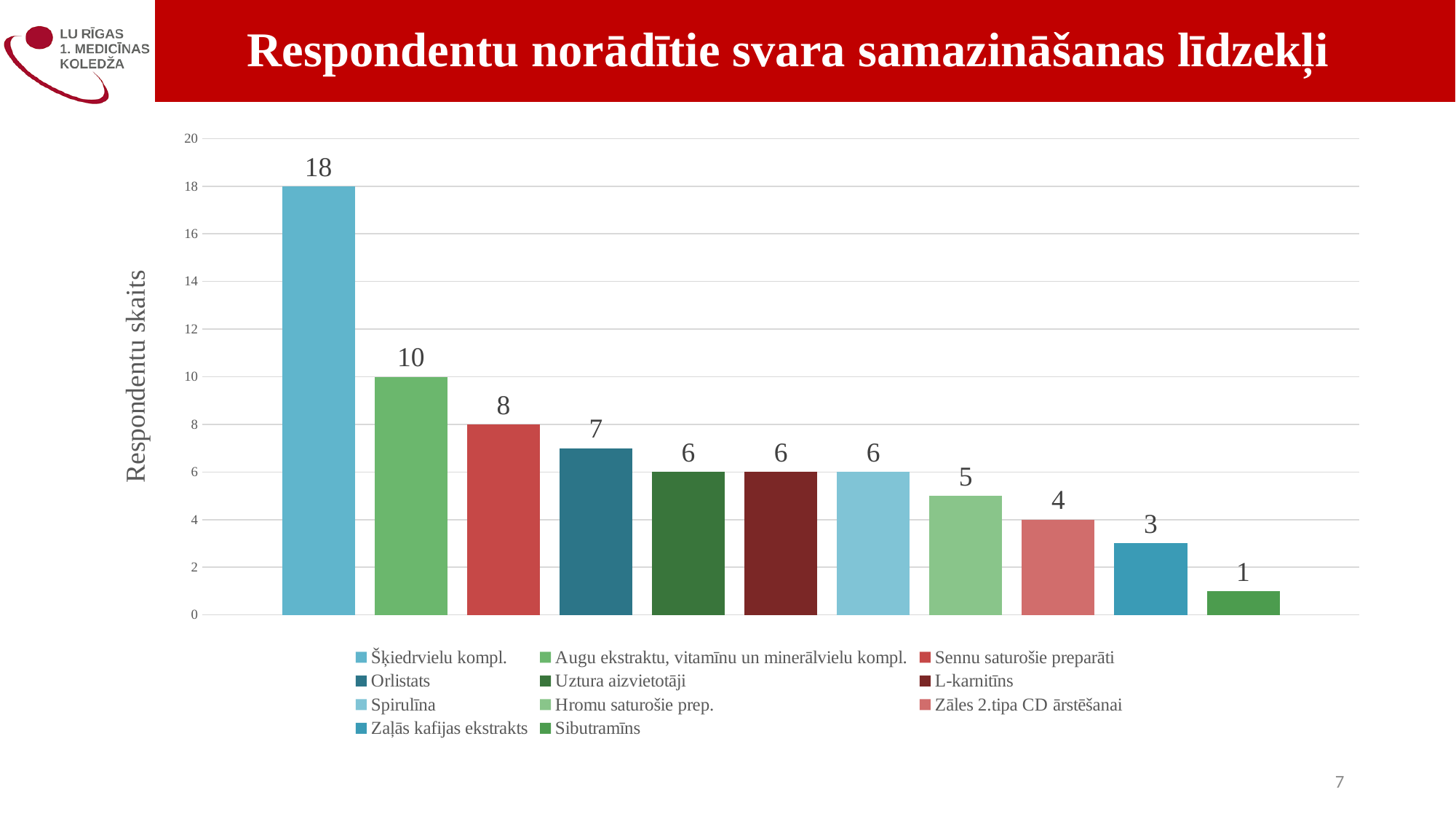
How many entries does the legend list? 11 What is the label of the vertical axis? Respondentu skaits Which weight-loss product has the highest number of respondents? Šķiedrvielu kompl. What is the value for Orlistats? 7 What is the value for Zāles 2.tipa CD ārstēšanai? 4 Which weight-loss product has the lowest number of respondents? Sibutramīns How many bars are plotted in the chart? 11 What kind of chart is shown on the slide? bar chart What is the difference between the values for Šķiedrvielu kompl. and Augu ekstraktu, vitamīnu un minerālvielu kompl.? 8 How many respondents indicated Šķiedrvielu kompl.? 18 Which has a larger value, Sennu saturošie preparāti or Hromu saturošie prep.? Sennu saturošie preparāti What is the value for Sibutramīns? 1